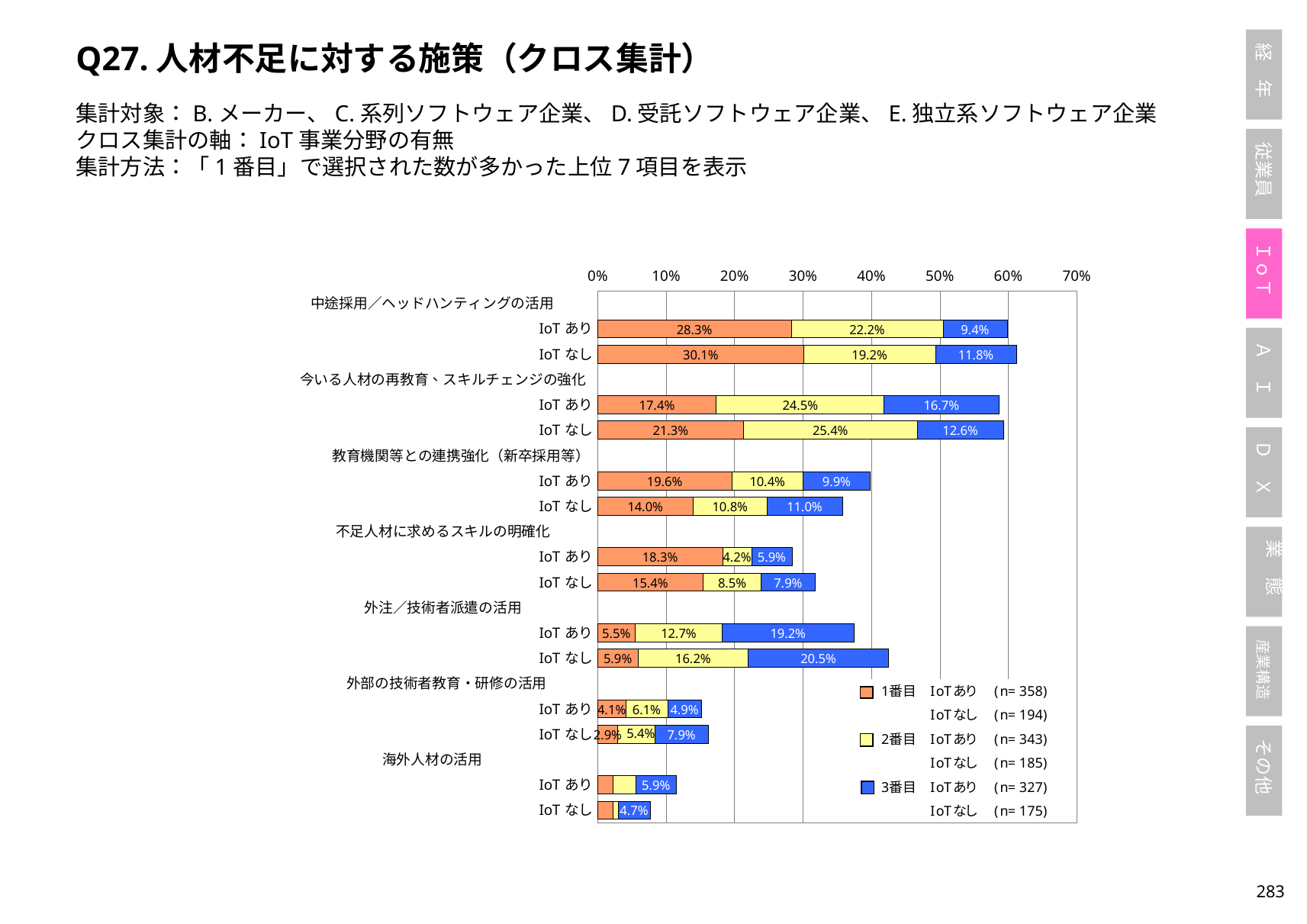
Which measure has the highest 1番目 value for IoTなし? 中途採用／ヘッドハンティングの活用 What is the total of the stacked bar for IoTあり under 中途採用／ヘッドハンティングの活用? 59.9% What is the difference between the 1番目 values for IoTなし and IoTあり under 中途採用／ヘッドハンティングの活用? 1.8 percentage points Which is larger: the 1番目 value for IoTあり or IoTなし under 教育機関等との連携強化（新卒採用等）? IoTあり How many series does the legend list? 3 What is the 3番目 value for IoTなし under 外注／技術者派遣の活用? 20.5% Is the total stacked bar for IoTなし under 外注／技術者派遣の活用 greater or less than 40%? greater What is the n value shown in the legend for 1番目 IoTあり? 358 How many measure categories (施策) are shown in the chart? 7 What kind of chart is shown on the slide? Stacked horizontal bar chart What is the 1番目 value for IoTあり under 中途採用／ヘッドハンティングの活用? 28.3% What is the 2番目 value for IoTなし under 今いる人材の再教育、スキルチェンジの強化? 25.4%